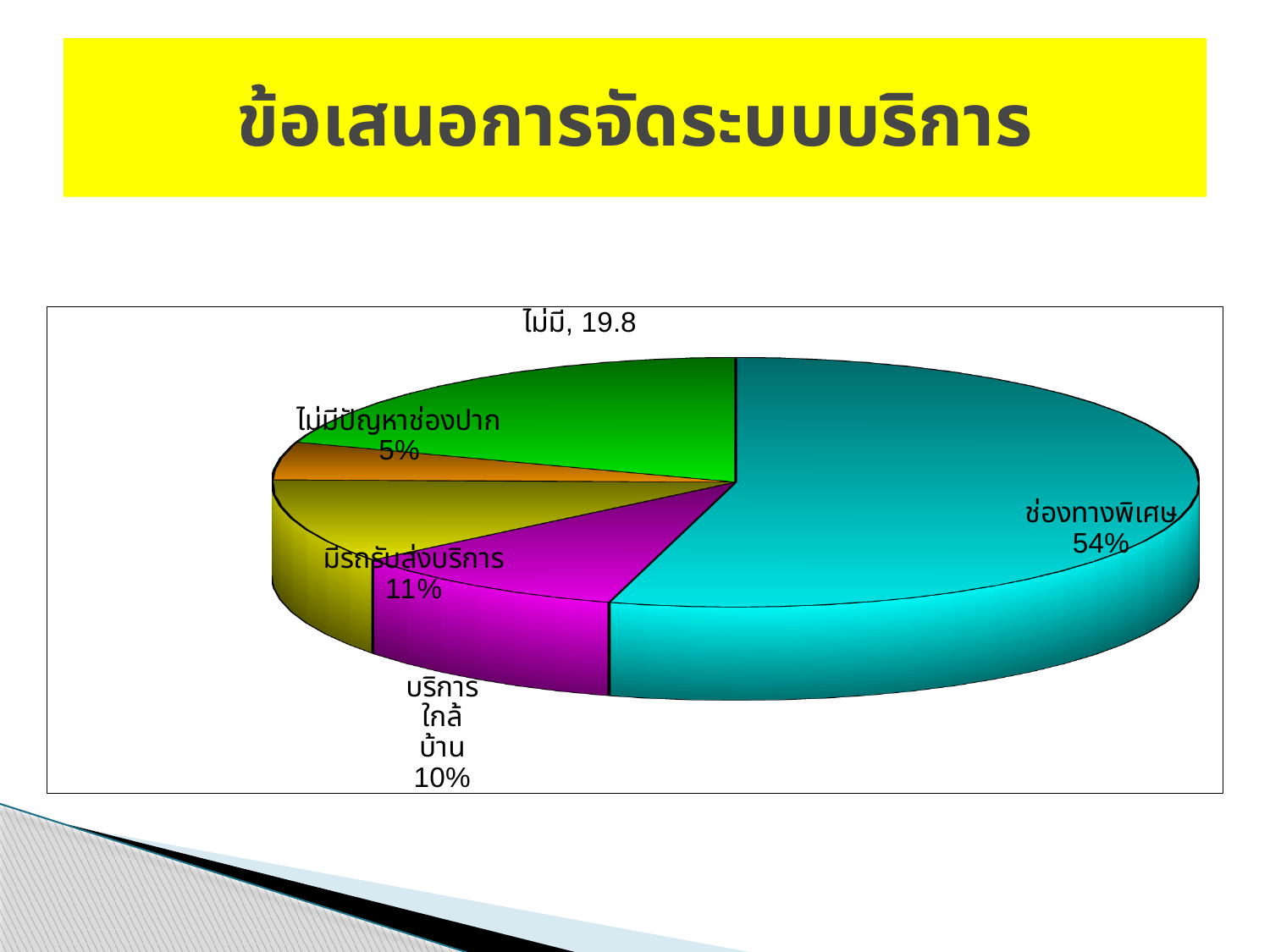
Which is larger, the slice for มีรถรับส่งบริการ or the slice for ไม่มีปัญหาช่องปาก? มีรถรับส่งบริการ What value is printed next to the label ไม่มี? 19.8 What is the value shown for บริการใกล้บ้าน? 10% What kind of chart is shown on the slide? pie chart How many slices does the pie chart have? 5 What is the difference between the value for ช่องทางพิเศษ and the value for มีรถรับส่งบริการ? 43% Which category has the largest slice of the pie? ช่องทางพิเศษ Which category has the smallest slice of the pie? ไม่มีปัญหาช่องปาก What colour is the slice for ช่องทางพิเศษ? teal (cyan) What is the value shown for ช่องทางพิเศษ? 54% What is the value shown for มีรถรับส่งบริการ? 11% What is the value shown for ไม่มีปัญหาช่องปาก? 5%